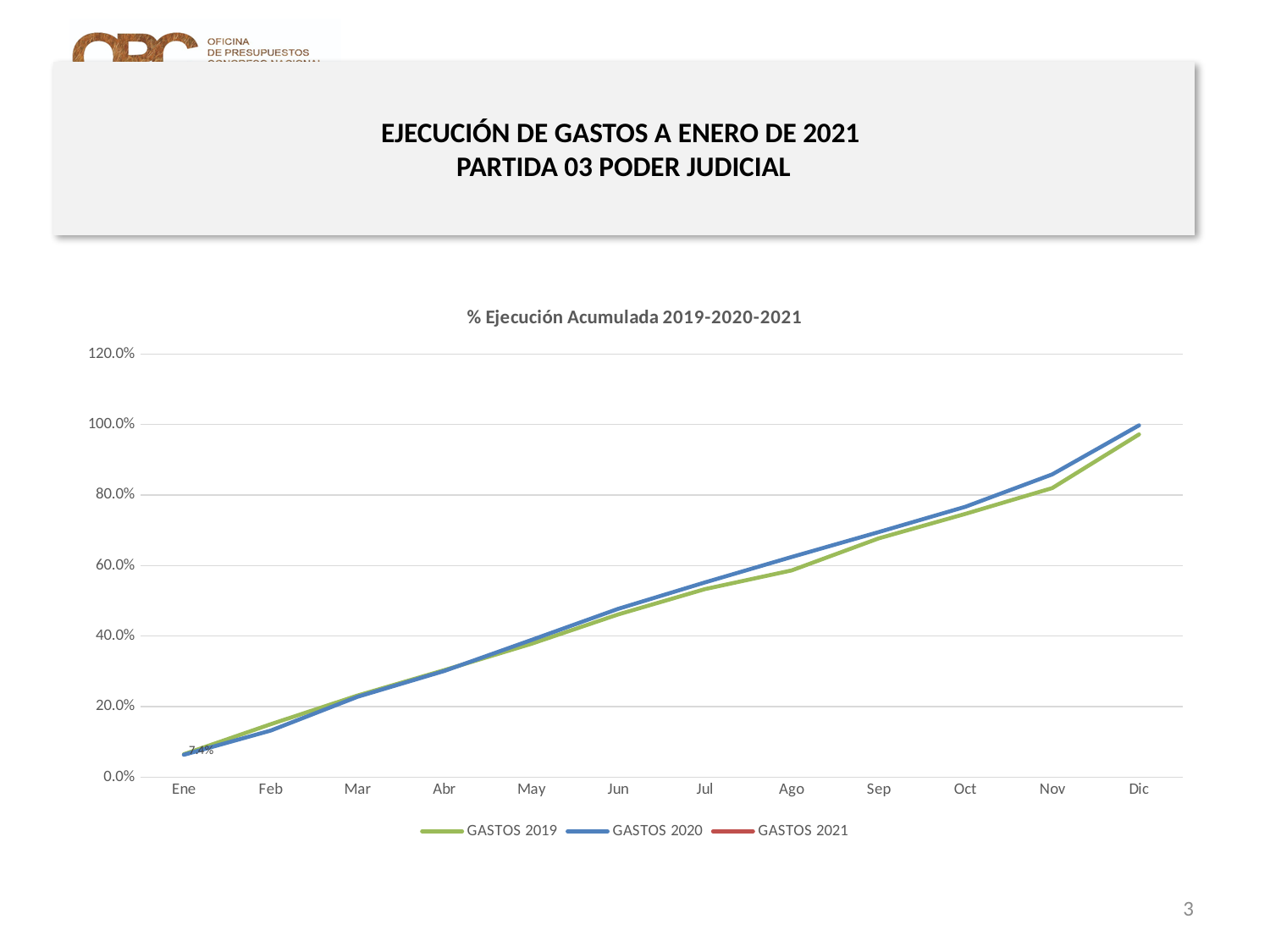
In which month does GASTOS 2020 reach its highest value? Dic What value is printed as a data label at Ene? 7.4% What kind of chart is shown on the slide? line chart In Feb, which series has the higher value, GASTOS 2019 or GASTOS 2020? GASTOS 2019 How many series does the legend list? 3 What is the title of the chart? % Ejecución Acumulada 2019-2020-2021 Is the value for GASTOS 2020 in Sep greater or less than 60.0%? greater Is the value for GASTOS 2020 in Dic greater or less than 80.0%? greater Is the value for GASTOS 2019 in Jun greater or less than 60.0%? less Do the GASTOS 2020 values rise or fall from Ene to Dic? rise How many months are shown along the x axis? 12 In Nov, which series has the higher value, GASTOS 2019 or GASTOS 2020? GASTOS 2020